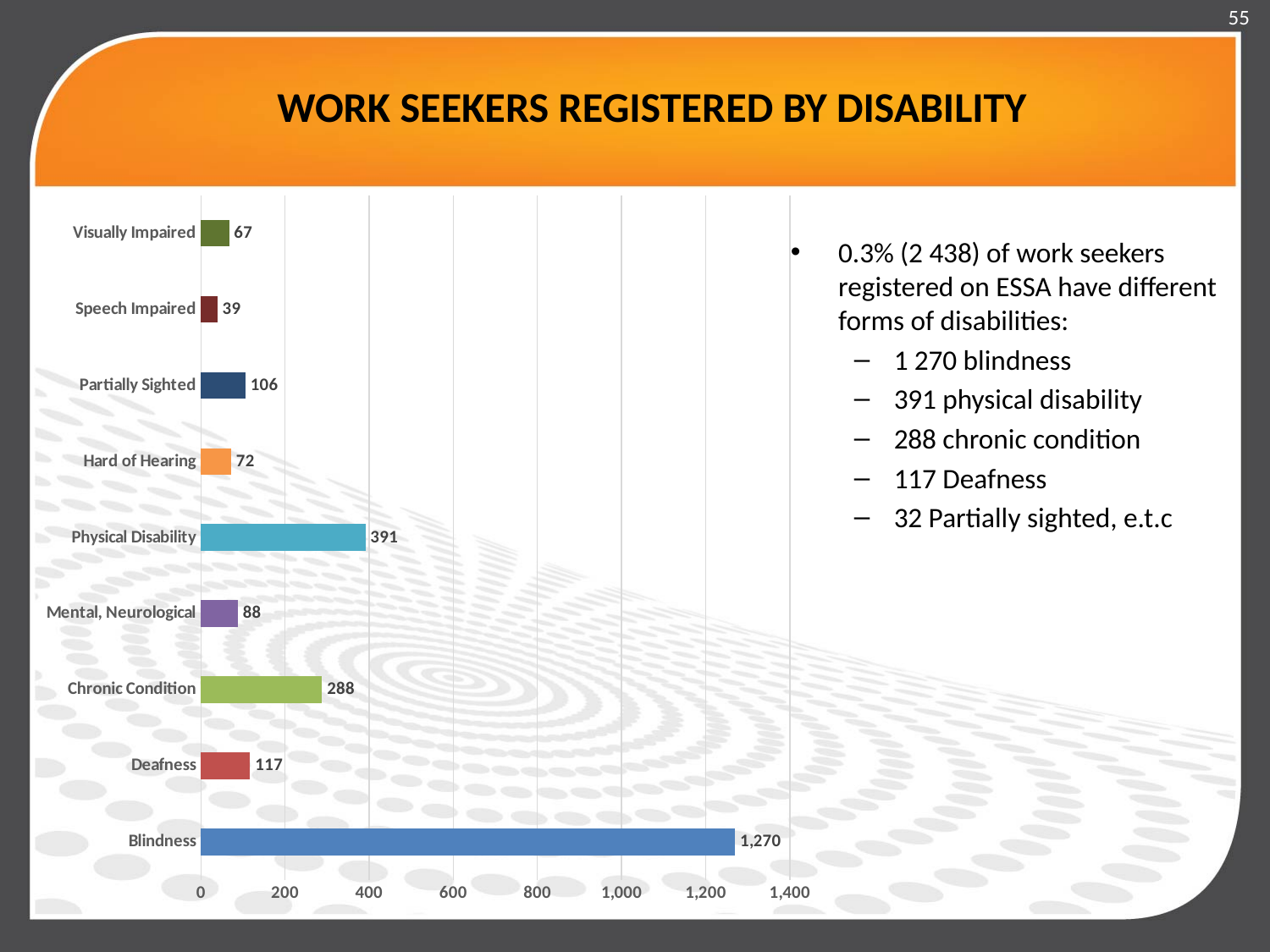
Which category has the lowest value? Speech Impaired Is the value for Chronic Condition greater or less than 200? greater How many categories are shown in the chart? 9 What is the value for Physical Disability? 391 What is the difference between the values for Chronic Condition and Deafness? 171 Which category has the highest value? Blindness What is the difference between the values for Blindness and Physical Disability? 879 Which is larger, the value for Partially Sighted or the value for Mental, Neurological? Partially Sighted What is the value for Blindness? 1,270 What is the value for Speech Impaired? 39 What kind of chart is shown on the slide? Bar chart What is the value for Hard of Hearing? 72